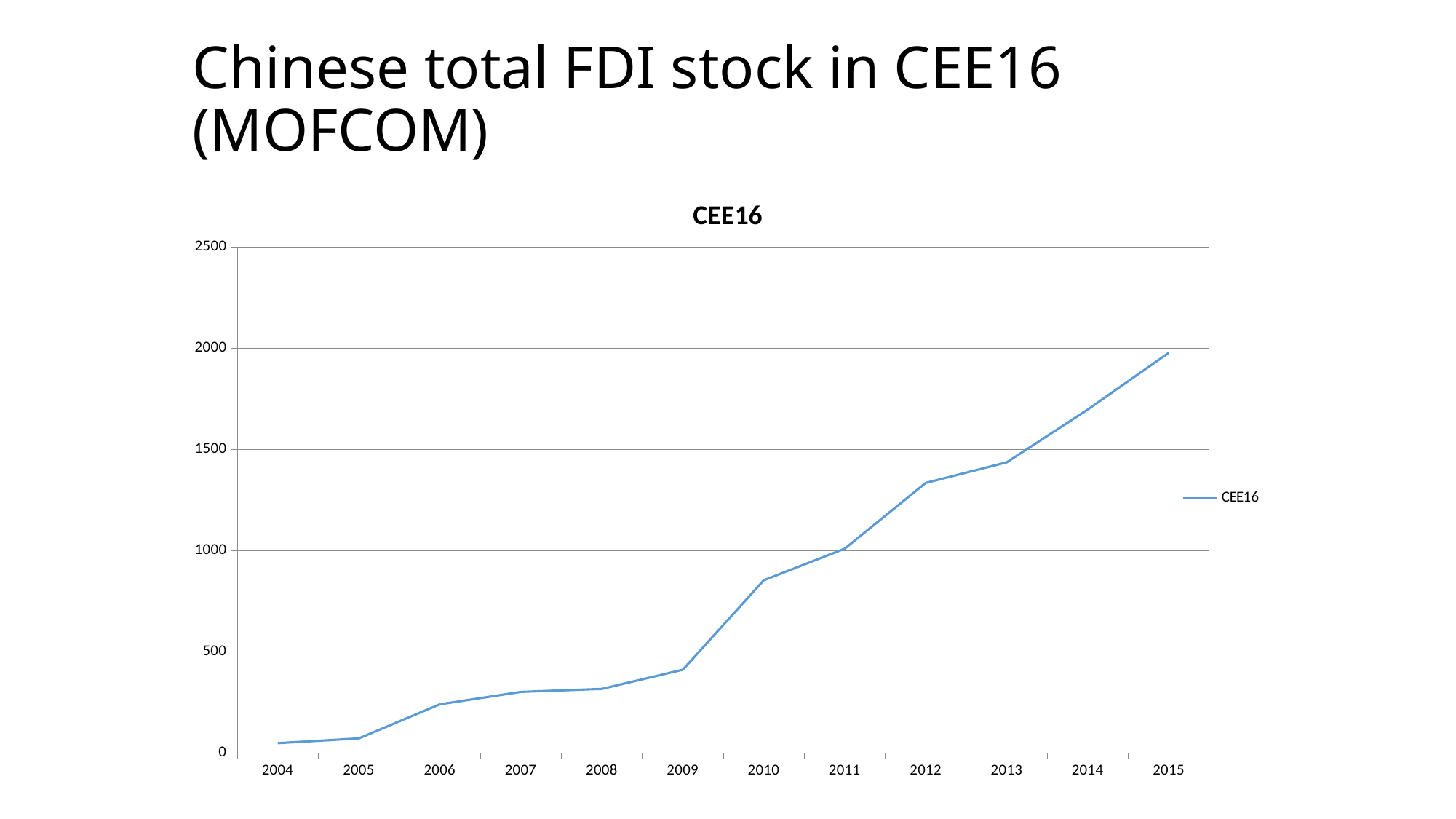
How many series does the legend list? 1 Do the values for CEE16 rise or fall from 2004 to 2015? rise Is the value for 2013 greater or less than 1500? less Which year has the larger value, 2009 or 2010? 2010 Which year has the lowest value for CEE16? 2004 Which year has the highest value for CEE16? 2015 How many years are plotted on the x axis of the chart? 12 What kind of chart is shown on the slide? line chart What is the title shown above the chart? CEE16 Is the value for 2009 greater or less than 500? less Is the value for 2014 greater or less than 1500? greater